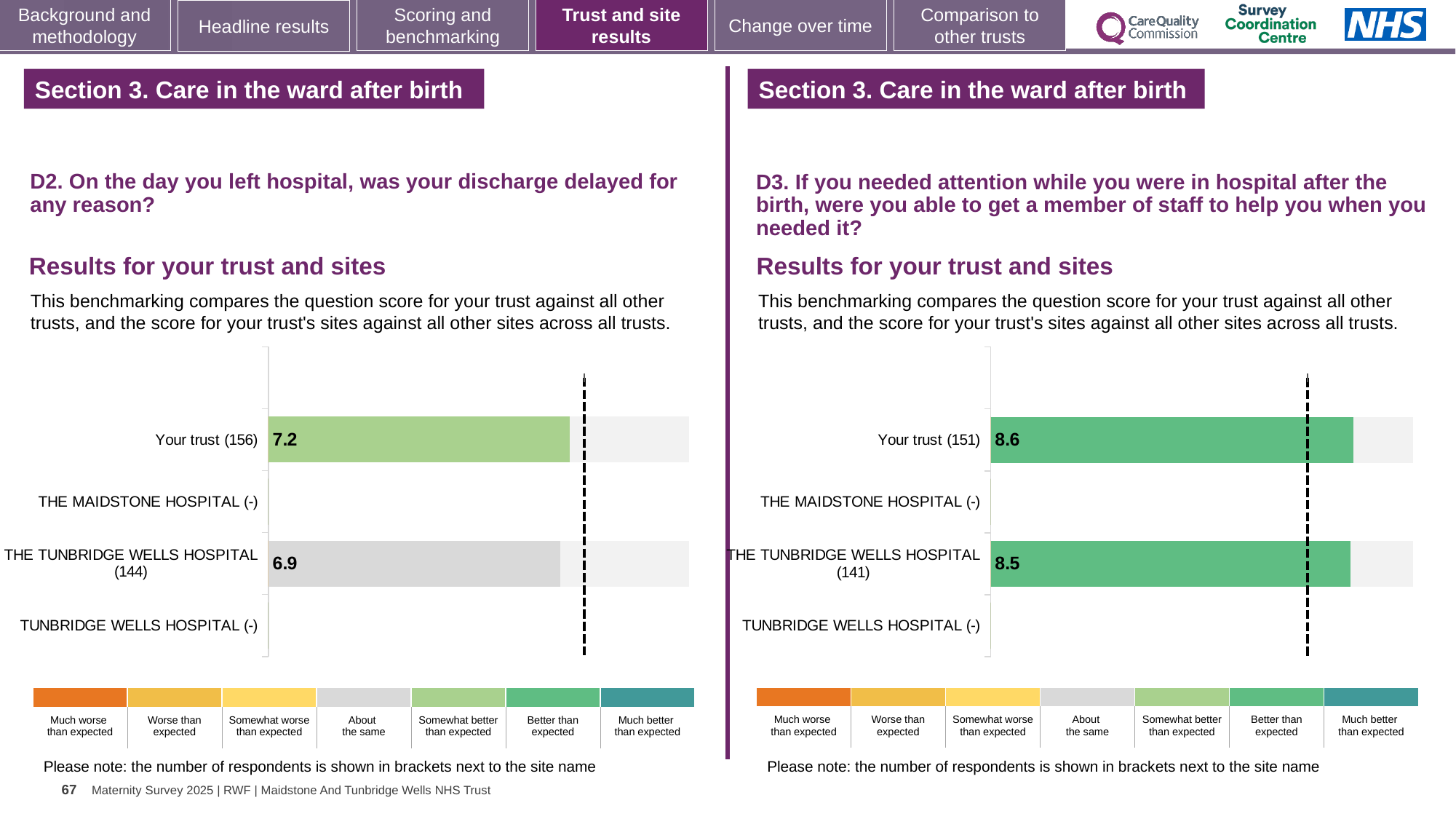
In the D2 chart (left), what is the difference between the score for Your trust (156) and THE TUNBRIDGE WELLS HOSPITAL (144)? 0.3 In the D3 chart (right), what is the difference between the score for Your trust (151) and THE TUNBRIDGE WELLS HOSPITAL (141)? 0.1 In the D2 chart (left), which has the higher score: Your trust (156) or THE TUNBRIDGE WELLS HOSPITAL (144)? Your trust (156) In the D3 chart (right), what is the score for THE TUNBRIDGE WELLS HOSPITAL (141)? 8.5 How many site/trust categories are listed on the y axis of the D2 chart (left)? 4 In the D3 chart (right), which benchmark category does the colour of the bar for Your trust (151) correspond to? Better than expected In the D3 chart (right), which has the higher score: Your trust (151) or THE TUNBRIDGE WELLS HOSPITAL (141)? Your trust (151) In the D2 chart (left), which benchmark category does the colour of the bar for THE TUNBRIDGE WELLS HOSPITAL (144) correspond to? About the same In the D2 chart (left), what is the score for Your trust (156)? 7.2 In the D3 chart (right), what is the score for Your trust (151)? 8.6 What kind of chart is used in the D3 chart (right)? Bar chart In the D2 chart (left), what is the score for THE TUNBRIDGE WELLS HOSPITAL (144)? 6.9